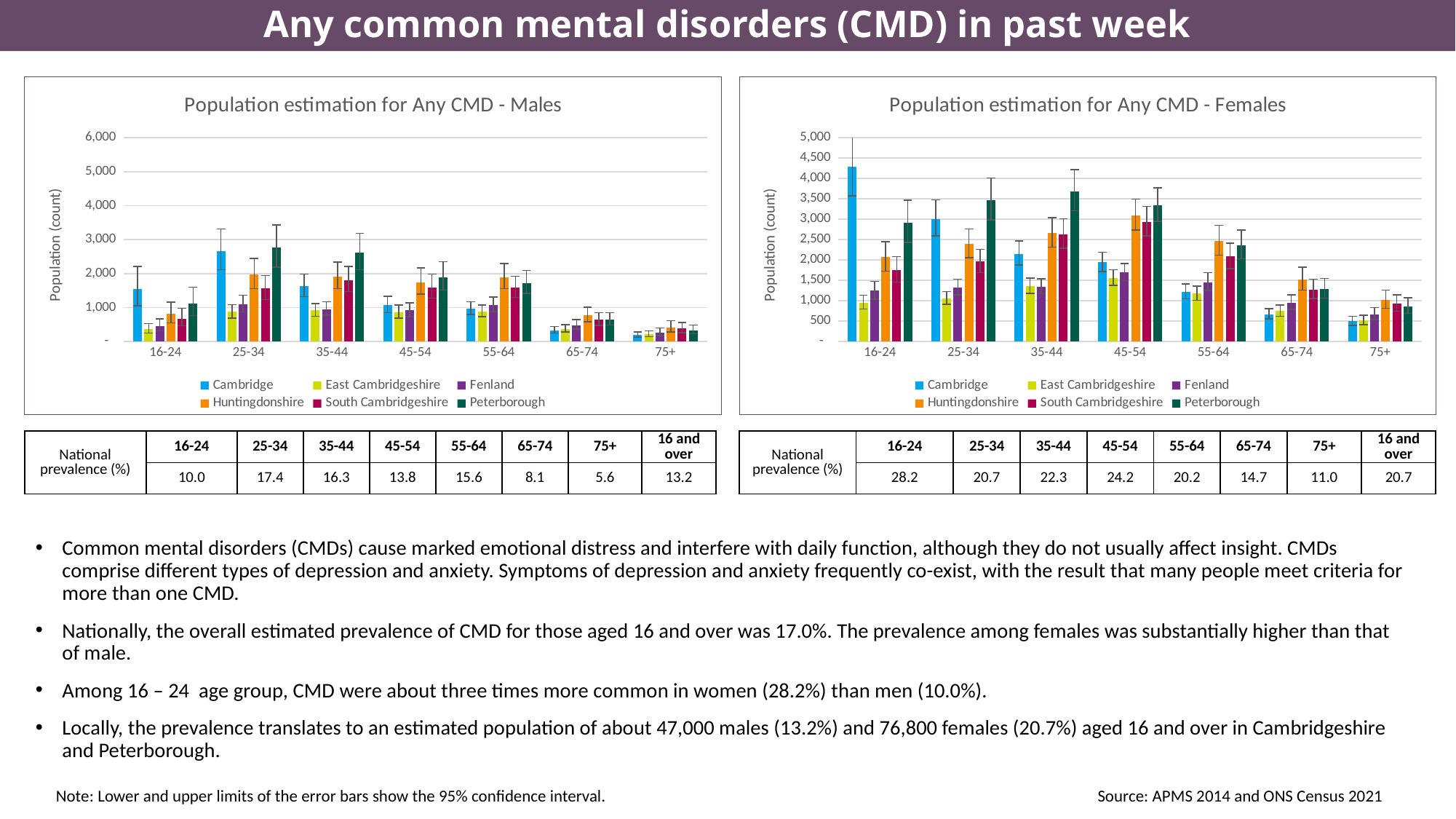
In the 'Population estimation for Any CMD - Males' chart, is the Cambridge value for 25-34 greater or less than 2,000? greater In the 'Population estimation for Any CMD - Males' chart, which age group has the lowest Peterborough bar? 75+ In the 'Population estimation for Any CMD - Females' chart, do the Cambridge values rise or fall from 16-24 to 75+? fall In the 'Population estimation for Any CMD - Females' chart, is the Peterborough value for 35-44 greater or less than 3,000? greater In the 'Population estimation for Any CMD - Males' chart, is the Huntingdonshire value for 16-24 greater or less than 1,000? less In the 'Population estimation for Any CMD - Males' chart, which is larger for 16-24: Cambridge or East Cambridgeshire? Cambridge What kind of chart is the 'Population estimation for Any CMD - Males' chart? bar chart How many age groups are shown on the x axis of the 'Population estimation for Any CMD - Males' chart? 7 How many series does the legend of the 'Population estimation for Any CMD - Females' chart list? 6 What is the y-axis label of the 'Population estimation for Any CMD - Females' chart? Population (count) In the 'Population estimation for Any CMD - Females' chart, which age group has the highest Cambridge bar? 16-24